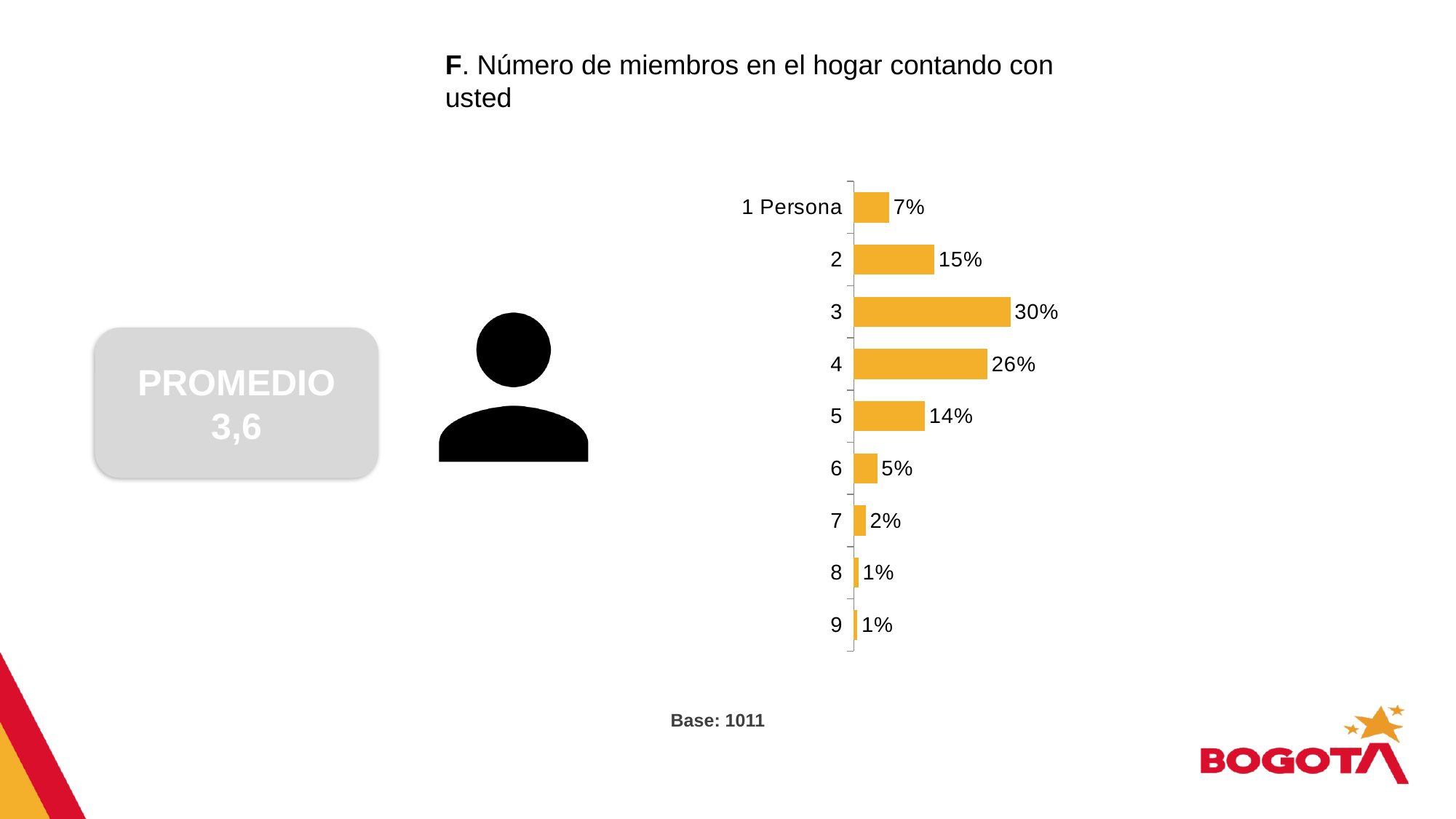
How many household size categories are shown in the chart? 9 What is the difference between the percentages for 2 members and 6 members? 10% What percentage of households have 5 members? 14% What is the value shown for '1 Persona'? 7% What is the base (number of respondents) stated below the chart? 1011 What is the combined percentage for households with 8 and 9 members? 2% Which is larger, the value for 2 members or the value for 5 members? 2 members What kind of chart is shown on the slide? Bar chart What is the difference between the percentages for 3 members and 4 members? 4% What percentage of households have 3 members? 30% Which household size category has the highest percentage? 3 Which is larger, the value for 6 members or the value for 7 members? 6 members